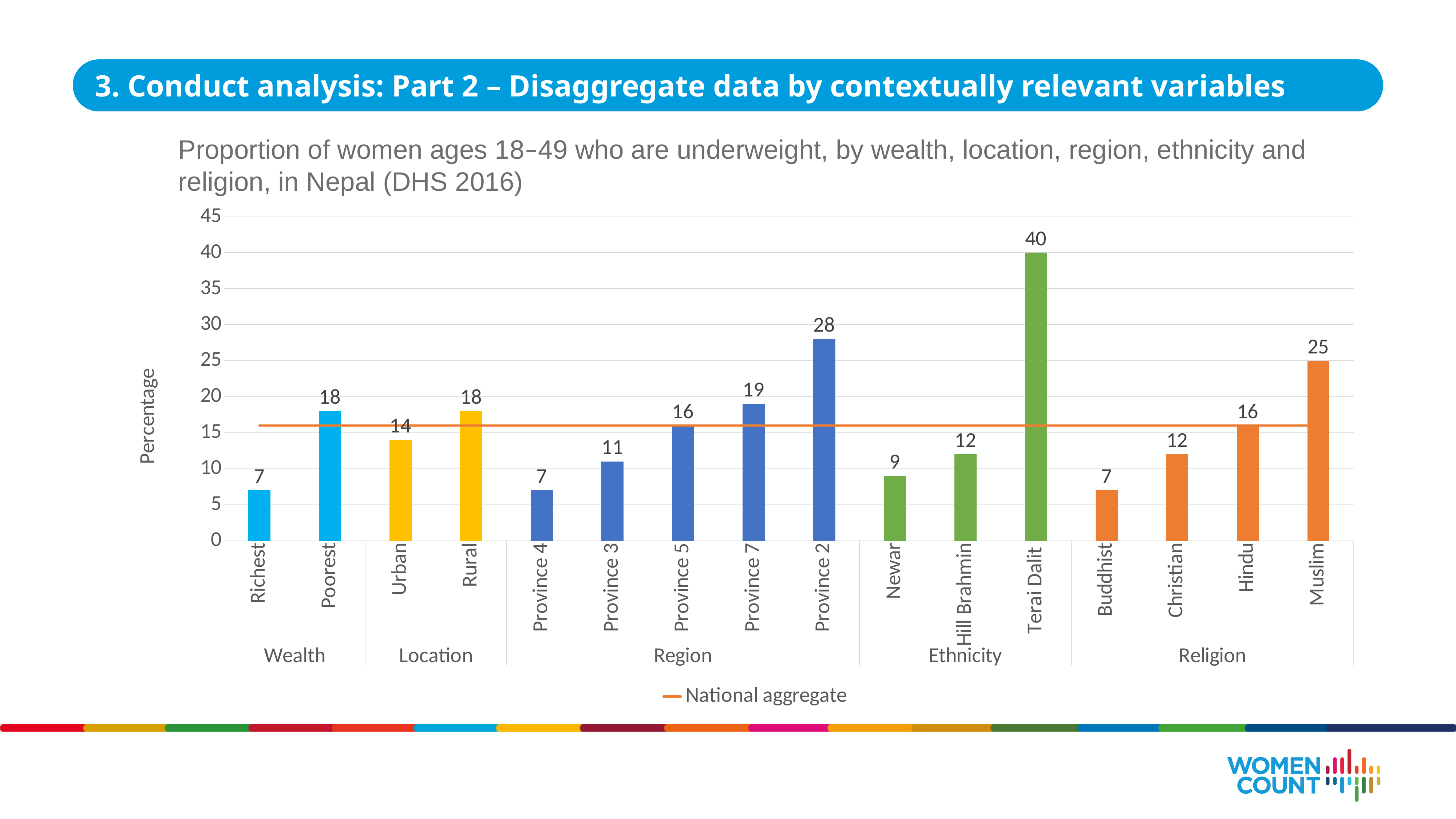
Do the values rise or fall from Province 4 to Province 2 within the Region group? Rise What kind of chart is shown on the slide? Bar chart What is the difference between the values for Poorest and Richest? 11 How many bars are plotted in the chart? 16 Is the value for Province 7 greater or less than 15? greater What does the orange horizontal line represent according to the legend? National aggregate What is the label of the vertical axis? Percentage What is the value for Urban? 14 Which is larger, the value for Muslim or the value for Hindu? Muslim Which category has the highest value? Terai Dalit What is the value for Terai Dalit? 40 What is the value for Province 2? 28